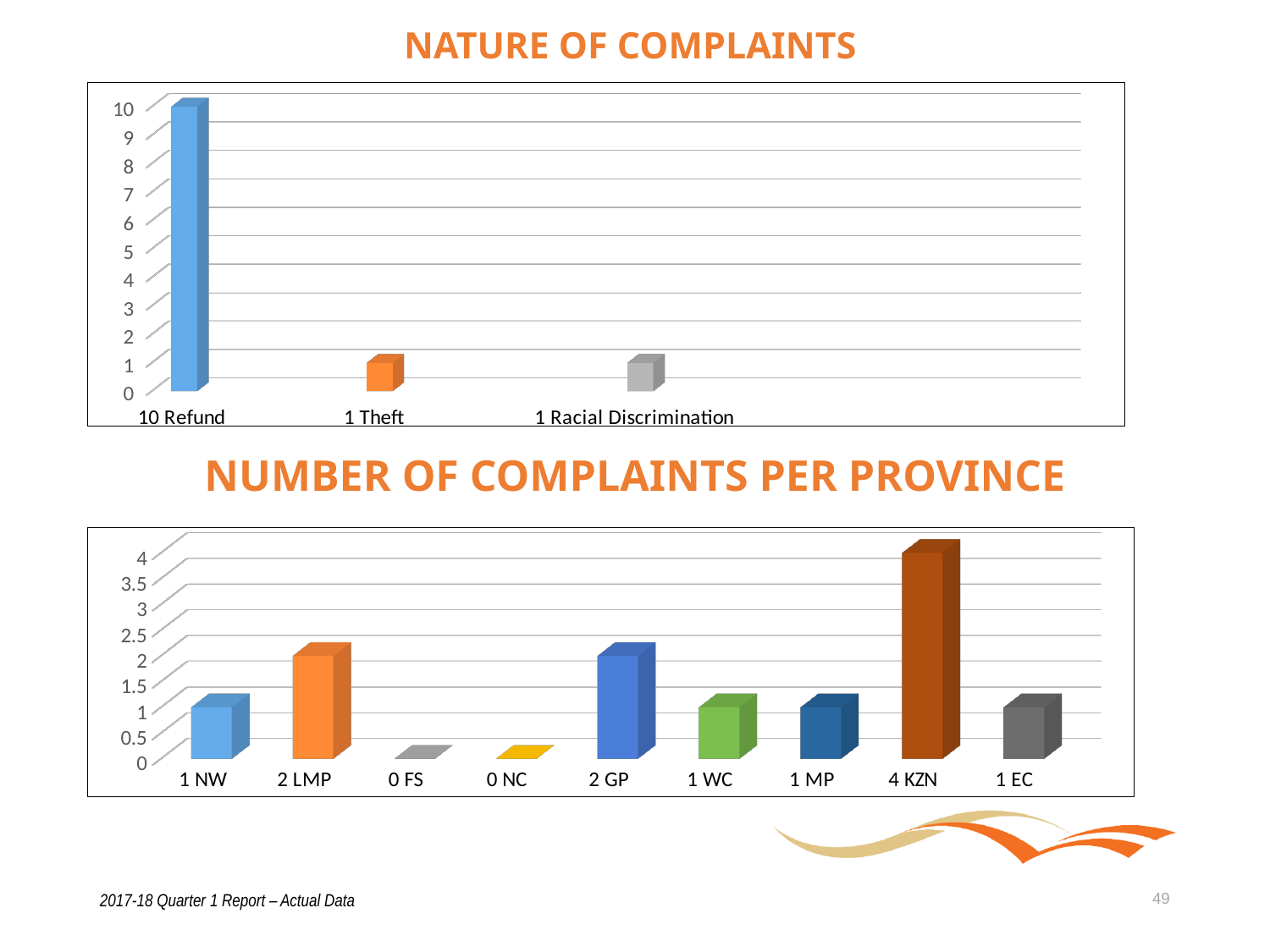
In the NUMBER OF COMPLAINTS PER PROVINCE chart, is the value for KZN greater or less than 3? greater What type of chart is the NATURE OF COMPLAINTS chart? Bar chart In the NUMBER OF COMPLAINTS PER PROVINCE chart, what is the difference between the KZN and GP values? 2 In the NATURE OF COMPLAINTS chart, how many complaints were about Refund? 10 In the NUMBER OF COMPLAINTS PER PROVINCE chart, which province has the highest number of complaints? KZN In the NATURE OF COMPLAINTS chart, what is the difference between the Refund and Theft values? 9 In the NUMBER OF COMPLAINTS PER PROVINCE chart, how many complaints does KZN have? 4 How many categories are shown in the NATURE OF COMPLAINTS chart? 3 In the NUMBER OF COMPLAINTS PER PROVINCE chart, which is larger, the value for LMP or the value for WC? LMP How many provinces are shown in the NUMBER OF COMPLAINTS PER PROVINCE chart? 9 In the NUMBER OF COMPLAINTS PER PROVINCE chart, which provinces have 0 complaints? FS and NC In the NATURE OF COMPLAINTS chart, which category has the highest value? Refund